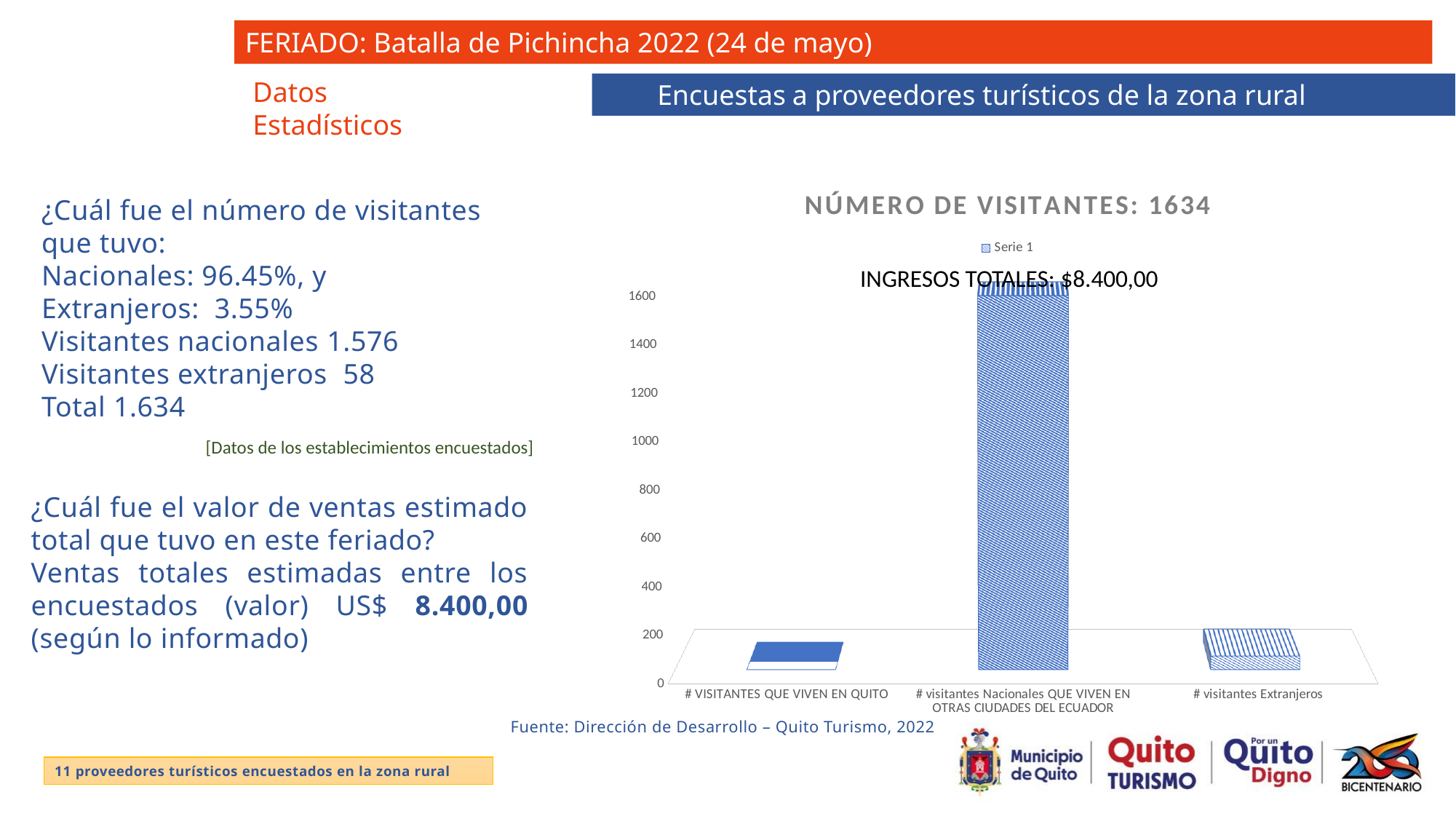
What is the name of the series shown in the chart legend? Serie 1 What kind of chart is shown on the slide? bar chart Is the value for '# VISITANTES QUE VIVEN EN QUITO' greater or less than 400? less Which category has the highest value in the chart? # visitantes Nacionales QUE VIVEN EN OTRAS CIUDADES DEL ECUADOR Is the value for '# visitantes Nacionales QUE VIVEN EN OTRAS CIUDADES DEL ECUADOR' greater or less than 1400? greater How many series does the chart legend list? 1 How many categories are plotted in the chart? 3 Is the value for '# visitantes Extranjeros' greater or less than 200? less Which is larger: the value for '# visitantes Nacionales QUE VIVEN EN OTRAS CIUDADES DEL ECUADOR' or the value for '# visitantes Extranjeros'? # visitantes Nacionales QUE VIVEN EN OTRAS CIUDADES DEL ECUADOR What is the title of the chart? NÚMERO DE VISITANTES: 1634